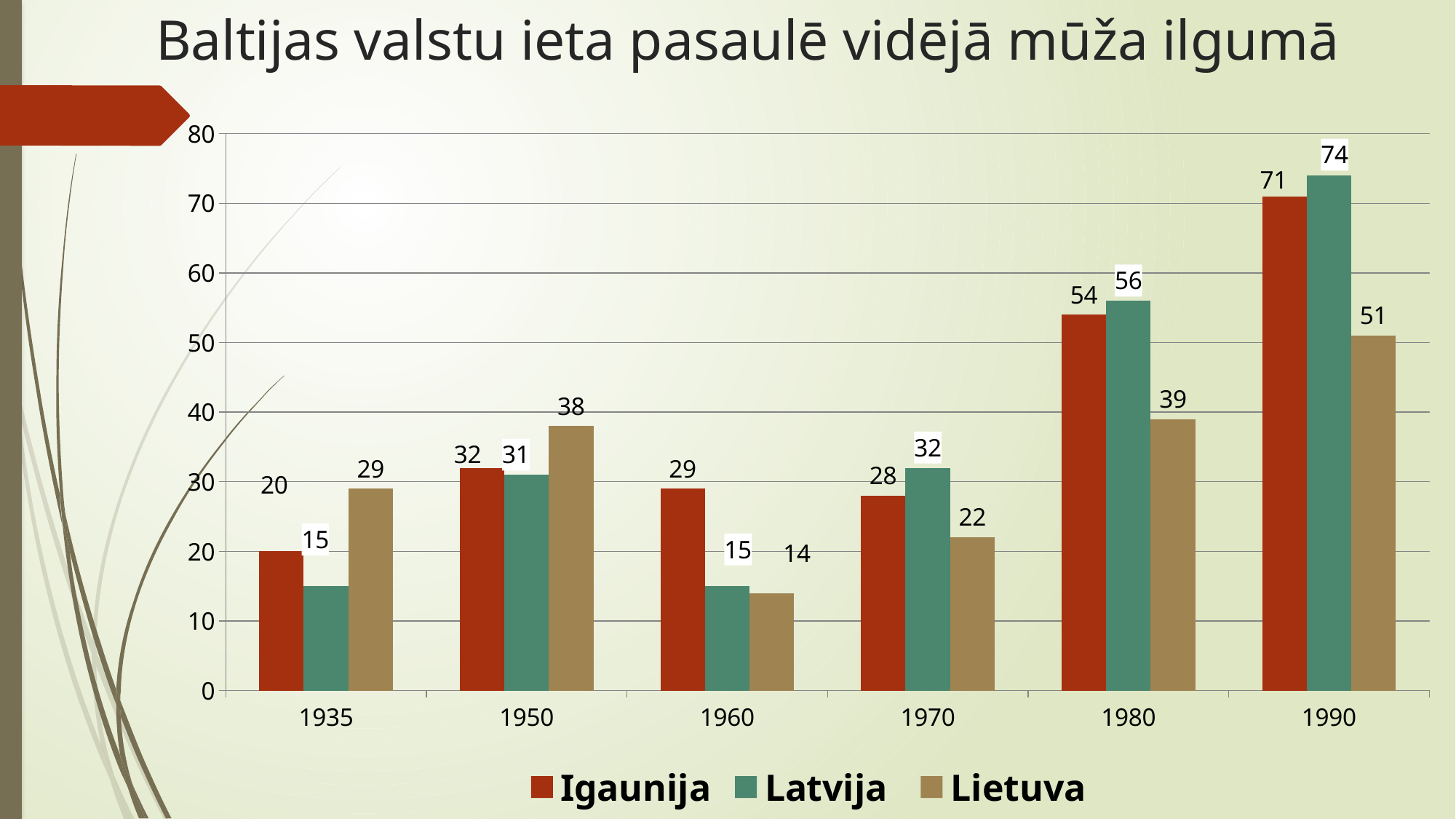
What is the value for Igaunija in 1960? 29 How many series does the legend list? 3 Which year has the lowest value for Lietuva? 1960 In 1935, which is larger: the value for Igaunija or the value for Latvija? Igaunija What is the title of the chart? Baltijas valstu ieta pasaulē vidējā mūža ilgumā What kind of chart is shown on the slide? bar chart Which year has the highest value for Igaunija? 1990 Is the value for Lietuva in 1990 greater or less than 40? greater What is the value for Latvija in 1990? 74 What is the value for Lietuva in 1950? 38 How many years are shown on the x axis? 6 What is the difference between the Latvija and Lietuva values in 1980? 17